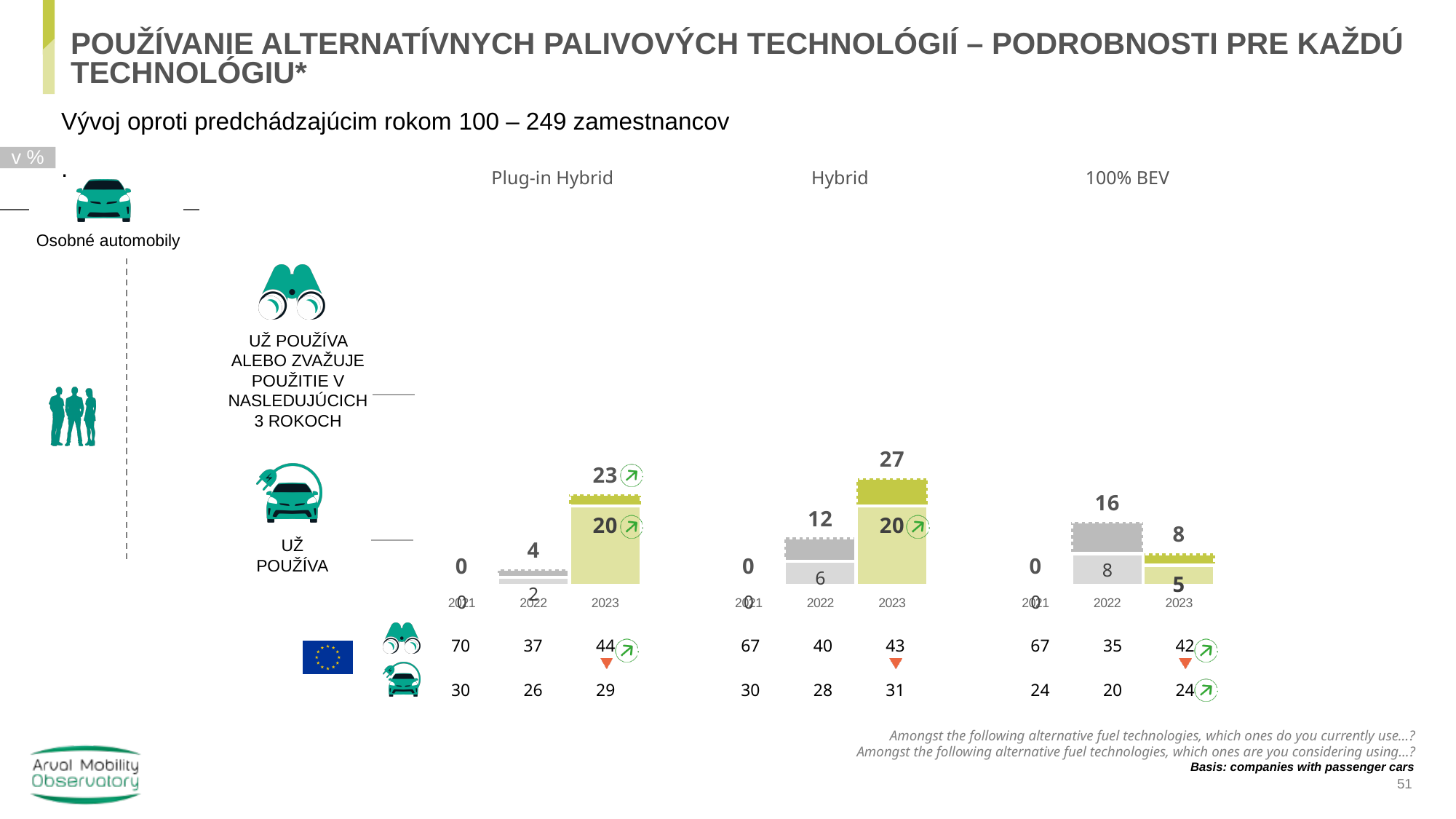
In the Plug-in Hybrid chart, what is the 'Už používa alebo zvažuje použitie v nasledujúcich 3 rokoch' value for 2023? 23 In the 100% BEV chart, is the 'Už používa alebo zvažuje použitie v nasledujúcich 3 rokoch' value larger in 2022 or 2023? 2022 How many years are shown on the x axis of the Plug-in Hybrid chart? 3 In the Hybrid chart, what is the difference between the 'Už používa alebo zvažuje použitie v nasledujúcich 3 rokoch' values for 2023 and 2022? 15 In the Plug-in Hybrid chart, what is the 'Už používa' value for 2023? 20 In the Hybrid chart, what is the 'Už používa' value for 2022? 6 In the 100% BEV chart, what is the 'Už používa' value for 2023? 5 In the 100% BEV chart, which year has the lowest 'Už používa' value? 2021 In the Hybrid chart, which year has the highest 'Už používa alebo zvažuje použitie v nasledujúcich 3 rokoch' value? 2023 In the Hybrid chart, what is the 'Už používa alebo zvažuje použitie v nasledujúcich 3 rokoch' value for 2022? 12 In the 100% BEV chart, what is the 'Už používa alebo zvažuje použitie v nasledujúcich 3 rokoch' value for 2022? 16 What kind of chart is used for the Hybrid data? Bar chart